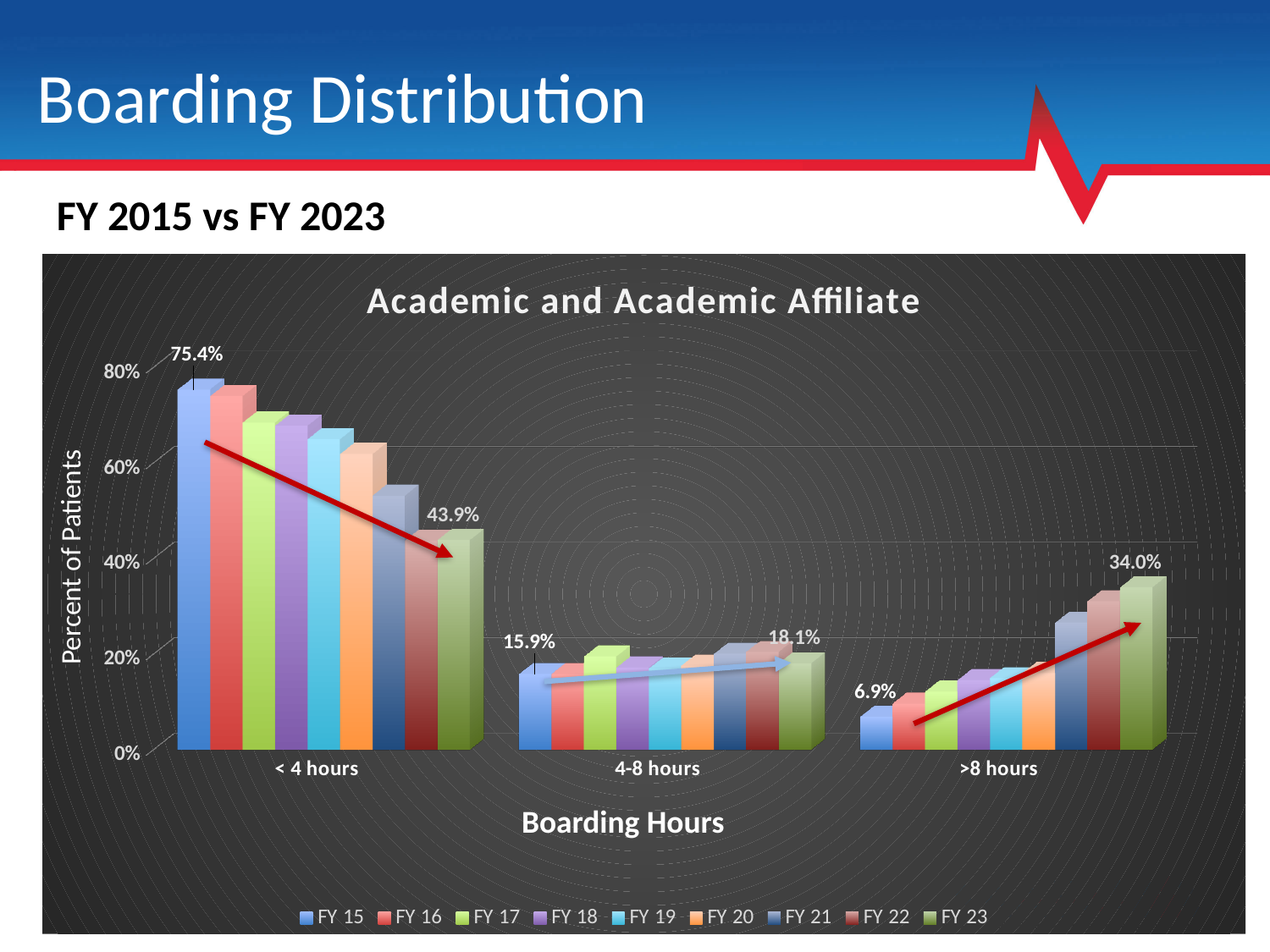
How many series does the legend list? 9 Which is larger in the 4-8 hours category: the FY 15 value or the FY 23 value? FY 23 What is the difference between the FY 23 and FY 15 values in the >8 hours category? 27.1% What kind of chart is shown on the slide? Bar chart What is the value for FY 23 in the < 4 hours category? 43.9% What is the difference between the FY 15 and FY 23 values in the < 4 hours category? 31.5% Is the FY 16 value for < 4 hours greater or less than 60%? greater What is the value for FY 15 in the < 4 hours category? 75.4% What is the value for FY 23 in the 4-8 hours category? 18.1% How many boarding-hour categories are shown on the x axis? 3 What is the title of the chart? Academic and Academic Affiliate What is the value for FY 15 in the >8 hours category? 6.9%